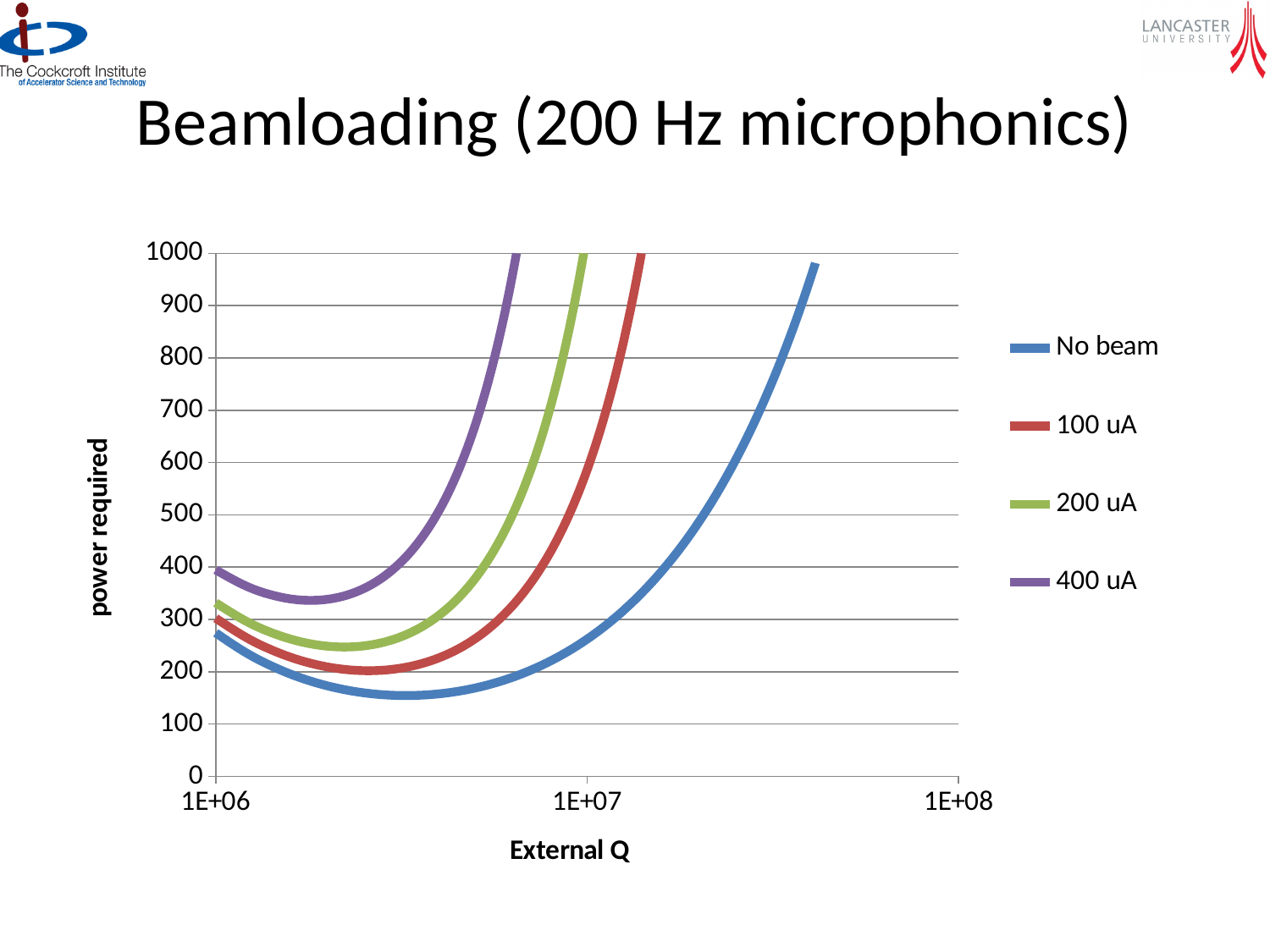
Is the minimum value of the No beam curve greater or less than 200? less Between External Q = 1E+07 and 1E+08, does the No beam curve rise or fall? rise What kind of chart is shown on the slide? line chart Which series reaches 1000 on the power required axis at the smallest External Q? 400 uA How many series does the legend list? 4 At External Q = 1E+06, which series has the higher power required, No beam or 400 uA? 400 uA Is the minimum value of the 200 uA curve greater or less than 300? less Which series has the highest power required at External Q = 1E+06? 400 uA Is the minimum value of the 400 uA curve greater or less than 300? greater Which series has the lowest minimum power required? No beam What are the series names listed in the legend? No beam, 100 uA, 200 uA, 400 uA What is the title of the x axis? External Q